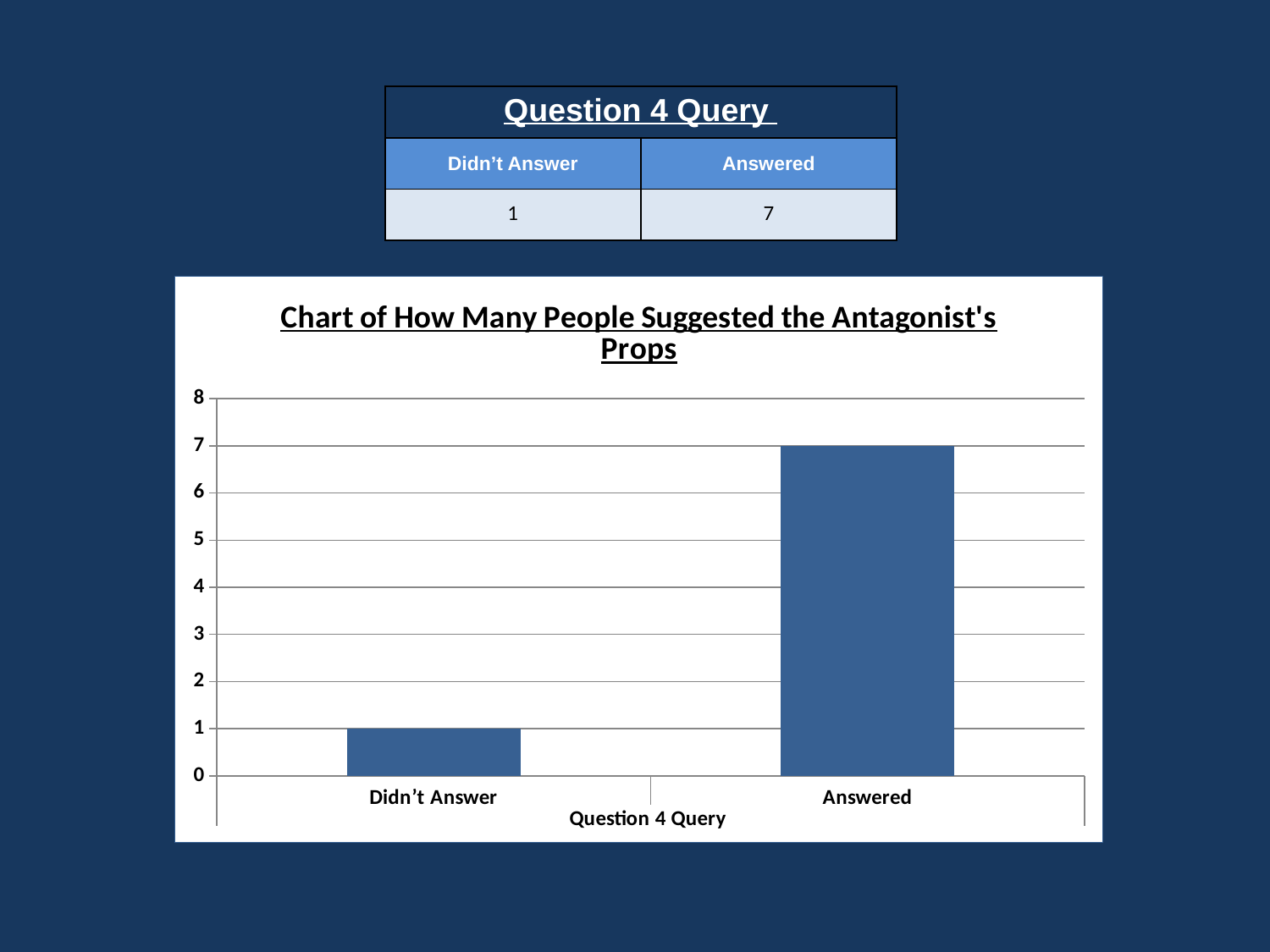
Which is larger, the value for Answered or the value for Didn't Answer? Answered Which category has the lowest value? Didn't Answer Which category has the highest value? Answered What is the label on the x axis of the chart? Question 4 Query What kind of chart is shown? Bar chart Is the value for Didn't Answer greater or less than 2? less What is the difference between the values for Answered and Didn't Answer? 6 What is the title of the chart? Chart of How Many People Suggested the Antagonist's Props How many categories are shown on the x axis? 2 Is the value for Answered greater or less than 4? greater What is the value for Answered? 7 What is the value for Didn't Answer? 1